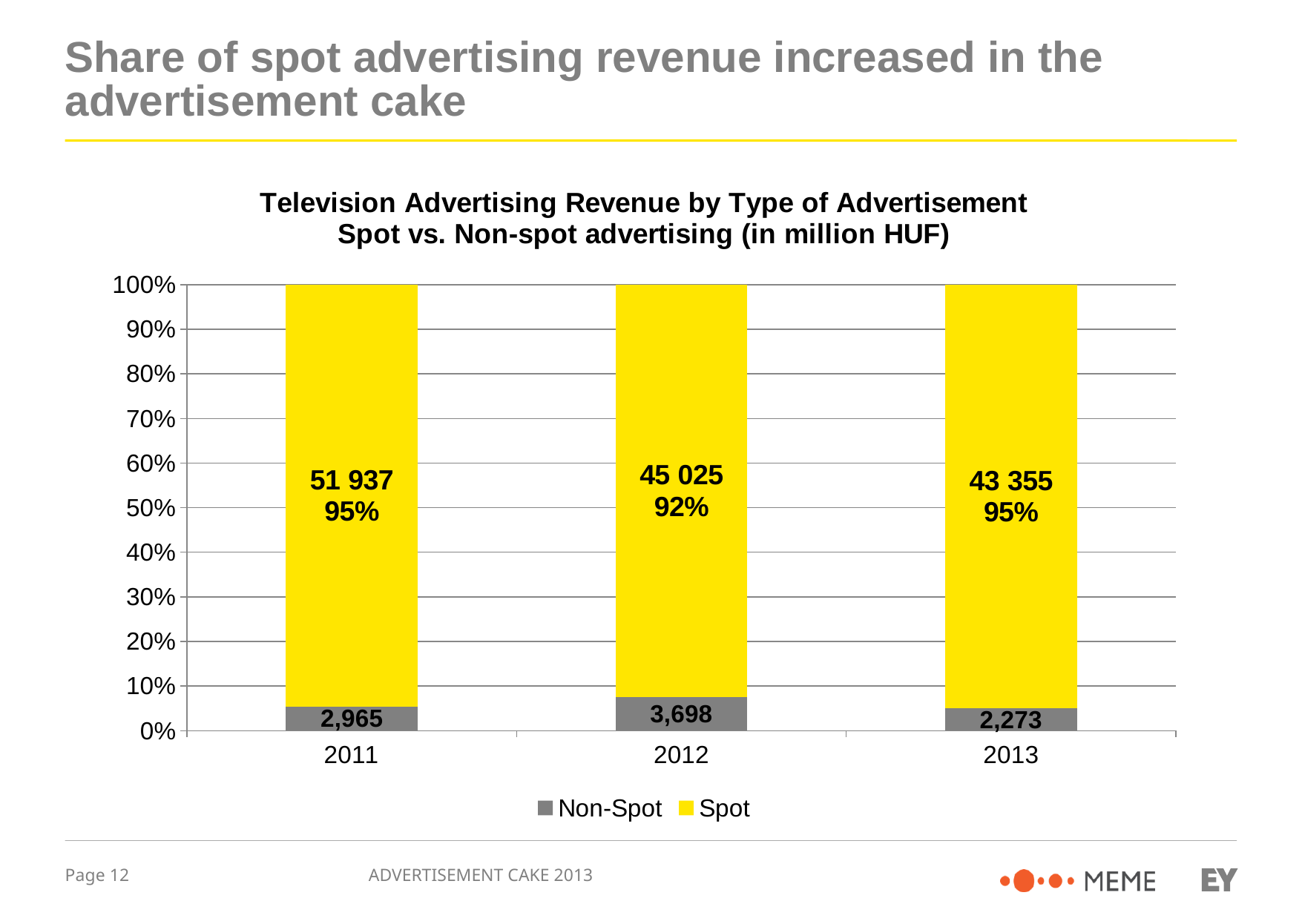
How many years are shown on the x axis? 3 What is the Spot advertising revenue for 2011? 51 937 Which is larger, the Non-Spot revenue in 2011 or in 2012? 2012 What percentage share does Spot advertising have in 2012? 92% In which year is the Non-Spot advertising revenue lowest? 2013 What is the Non-Spot advertising revenue for 2013? 2,273 What is the difference between the Spot revenue in 2011 and in 2012? 6 912 What is the Non-Spot advertising revenue for 2012? 3,698 In which year is the Spot advertising revenue highest? 2011 How many series does the legend list? 2 What kind of chart is shown on the slide? Stacked bar chart Does the Spot advertising revenue rise or fall from 2011 to 2013? Fall